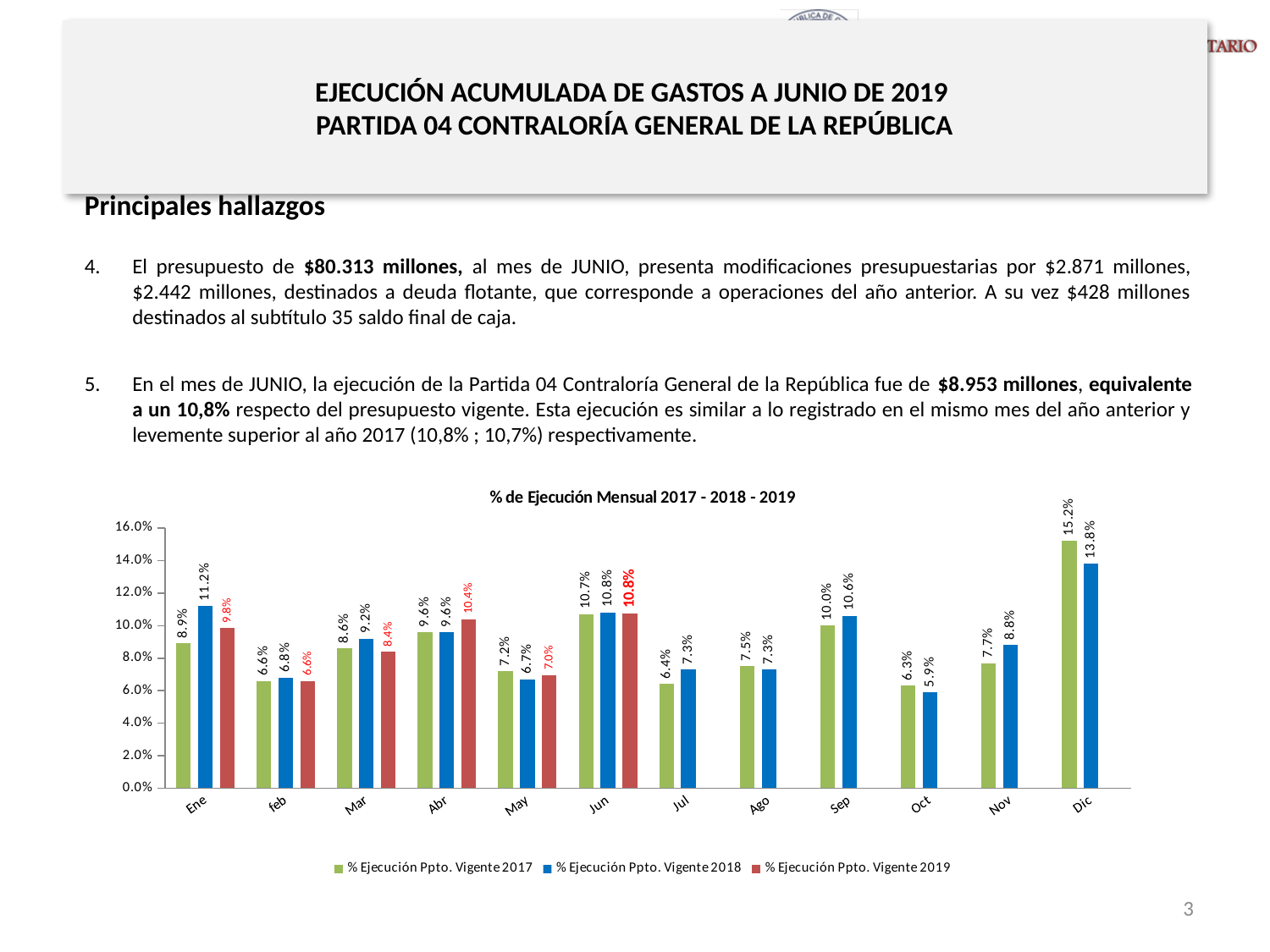
What kind of chart is shown on the slide? bar chart How many series does the legend list? 3 How many months are shown on the x axis? 12 Is the value for % Ejecución Ppto. Vigente 2017 in Sep greater or less than 8.0%? greater What is the title of the chart? % de Ejecución Mensual 2017 - 2018 - 2019 What is the difference between the 2017 and 2018 values in Dic? 1.4% What is the value for % Ejecución Ppto. Vigente 2018 in Ene? 11.2% Which month has the highest value for % Ejecución Ppto. Vigente 2018? Dic Which month has the lowest value for % Ejecución Ppto. Vigente 2017? Oct What is the value for % Ejecución Ppto. Vigente 2019 in Abr? 10.4% Which is larger in Ene: the 2018 value or the 2019 value? 2018 What is the value for % Ejecución Ppto. Vigente 2017 in Dic? 15.2%